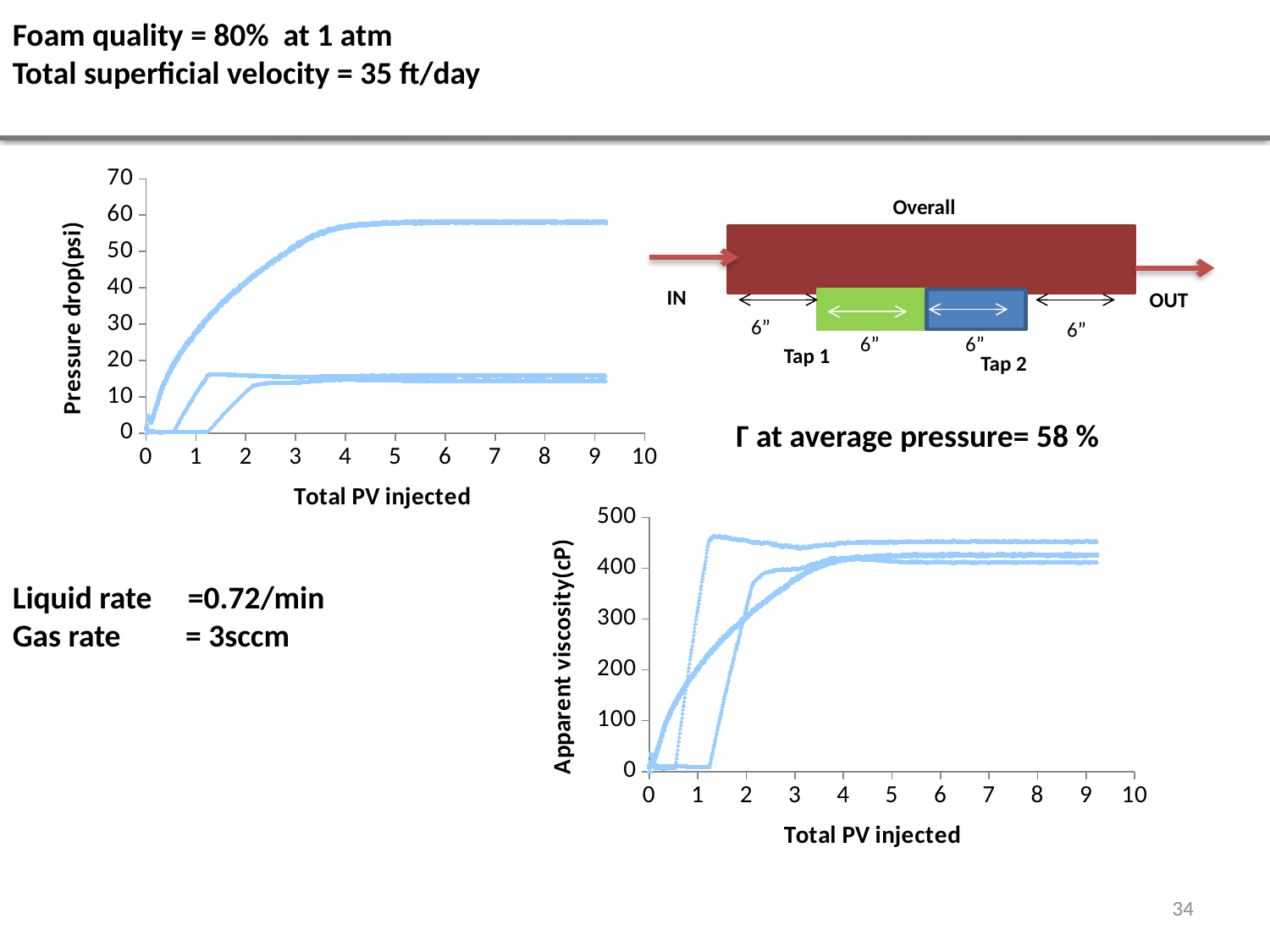
How many curves are plotted on the apparent viscosity chart? 3 On the pressure drop chart, are the plateau values of the two lower curves greater or less than 20 psi? less On the pressure drop chart, is the plateau value of the highest curve greater or less than 50 psi? greater On the apparent viscosity chart, is the highest plateau value greater or less than 500 cP? less What is the maximum value shown on the x axis of the apparent viscosity chart? 10 What is the y-axis label of the chart on the left of the slide? Pressure drop(psi) On the pressure drop chart, how do the curves change as Total PV injected increases from 0 to about 4? they rise and then level off What is the y-axis label of the chart at the bottom right of the slide? Apparent viscosity(cP) What kind of chart is the pressure drop chart on the left of the slide? line chart How many curves are plotted on the pressure drop chart? 3